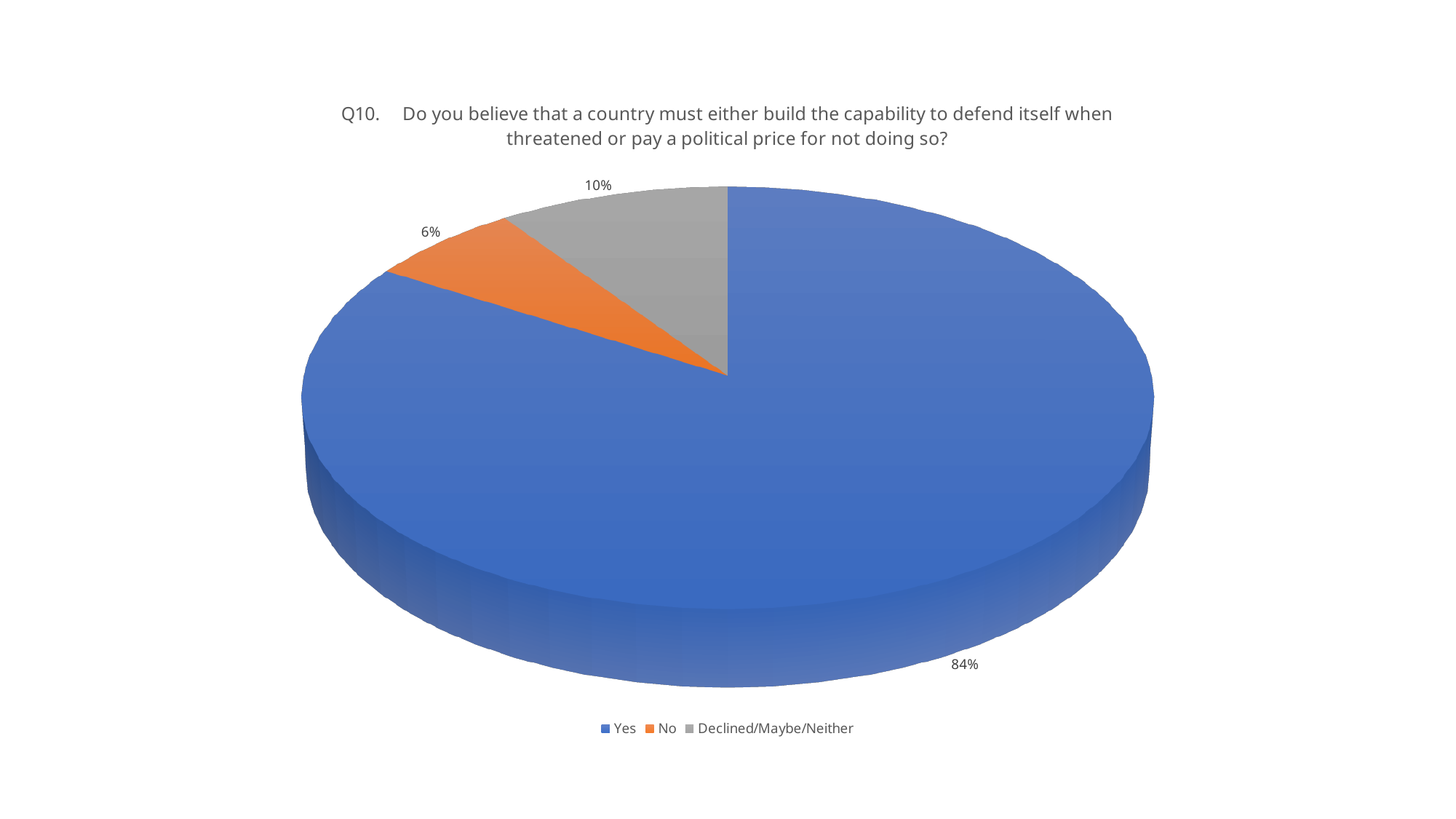
What colour is the slice representing No? Orange What percentage of respondents answered No? 6% How many slices does the pie chart have? 3 What percentage of respondents fall under Declined/Maybe/Neither? 10% Which is larger, the share for No or the share for Declined/Maybe/Neither? Declined/Maybe/Neither What percentage of respondents answered Yes? 84% Which response has the largest share of the pie? Yes What is the difference in percentage points between the Declined/Maybe/Neither and No shares? 4 Which response has the smallest share of the pie? No What question number is shown in the chart title? Q10 What kind of chart is shown on the slide? Pie chart What is the difference in percentage points between the Yes and No shares? 78